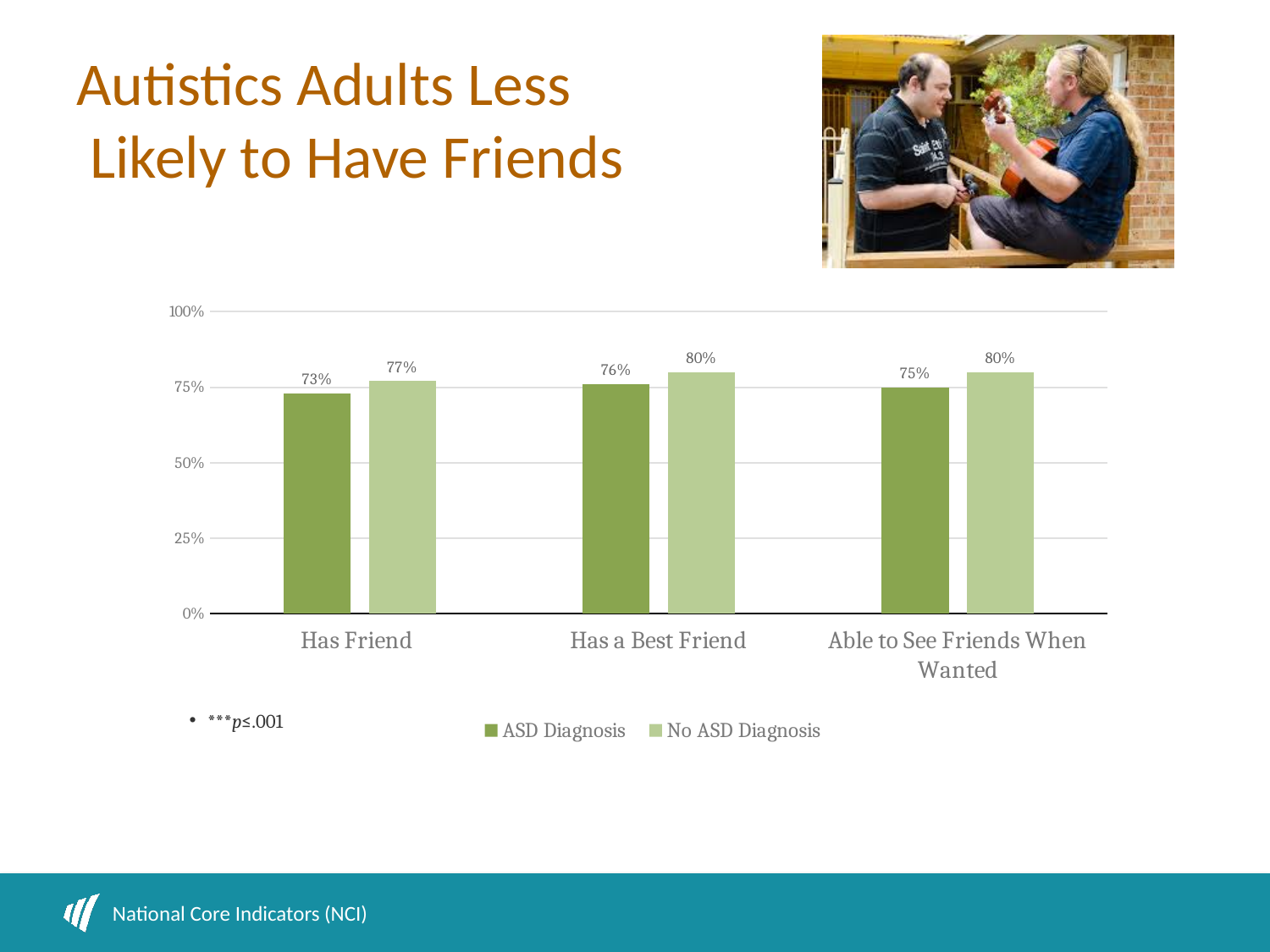
Is the ASD Diagnosis value for 'Has Friend' greater or less than 75%? less Which is larger in the 'Has a Best Friend' category: ASD Diagnosis or No ASD Diagnosis? No ASD Diagnosis What percentage of adults with no ASD diagnosis have a best friend? 80% Which category has the lowest value for the ASD Diagnosis series? Has Friend What is the difference between the No ASD Diagnosis and ASD Diagnosis values for 'Able to See Friends When Wanted'? 5% How many series does the chart legend list? 2 What is the value for ASD Diagnosis in the 'Able to See Friends When Wanted' category? 75% What is the value for No ASD Diagnosis in the 'Has Friend' category? 77% What is the difference between the No ASD Diagnosis and ASD Diagnosis values for 'Has Friend'? 4% What type of chart is shown on the slide? Bar chart What percentage of adults with an ASD diagnosis have a friend? 73% How many categories are shown on the x axis of the chart? 3